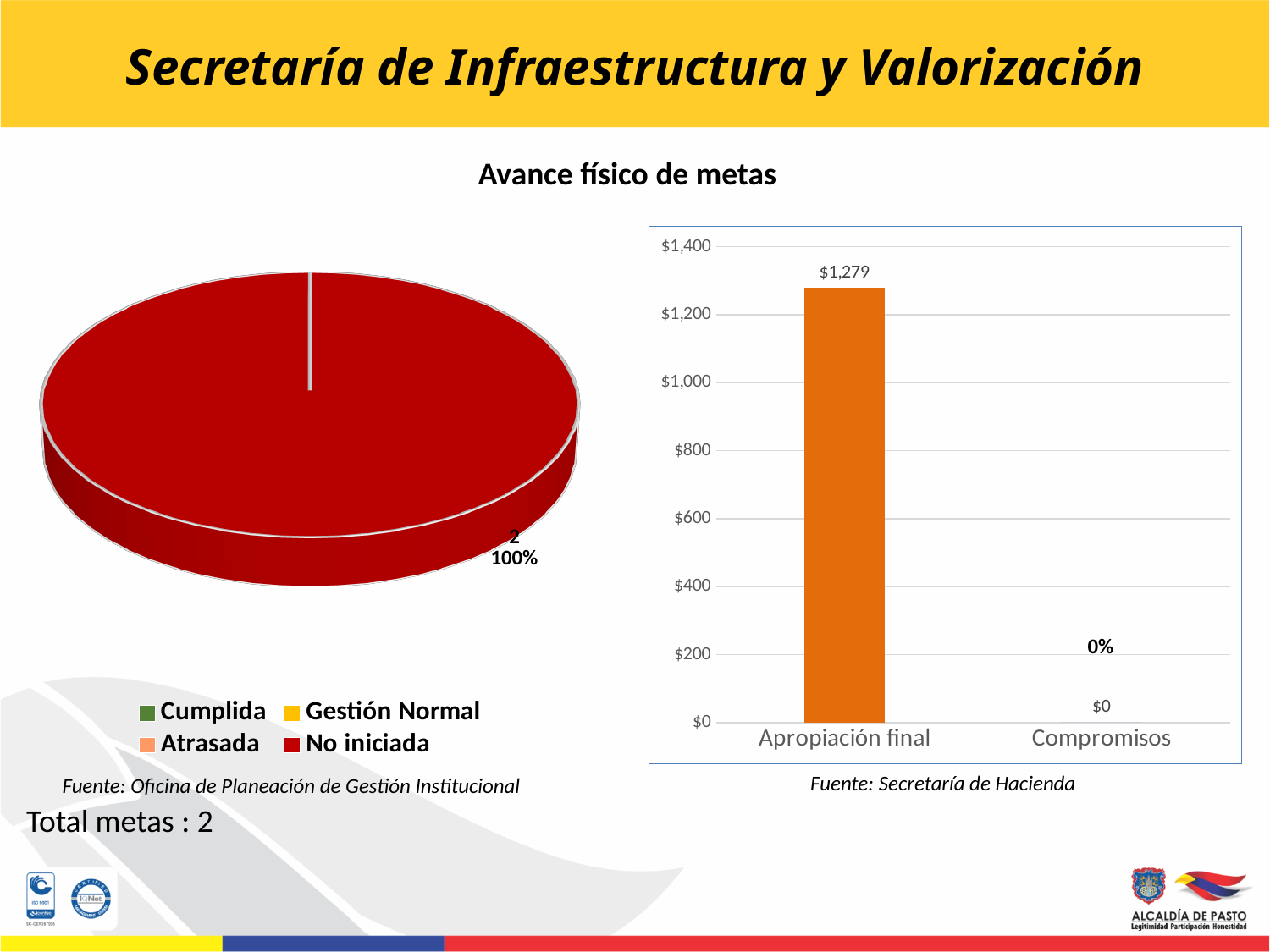
How many categories are shown on the x axis of the bar chart on the right? 2 In the bar chart on the right, which category has the highest value? Apropiación final What kind of chart is the chart on the right of the slide? bar chart In the bar chart on the right, what percentage label is shown above Compromisos? 0% How many entries does the legend of the pie chart on the left list? 4 In the bar chart on the right, what is the value for Apropiación final? $1,279 In the bar chart on the right, what is the difference between Apropiación final and Compromisos? $1,279 In the bar chart on the right, which category has the lowest value? Compromisos What kind of chart is the chart on the left of the slide? pie chart In the pie chart on the left, what share of the pie does the No iniciada slice represent? 100% In the bar chart on the right, is the value for Apropiación final greater or less than $1,200? greater In the bar chart on the right, what is the value for Compromisos? $0